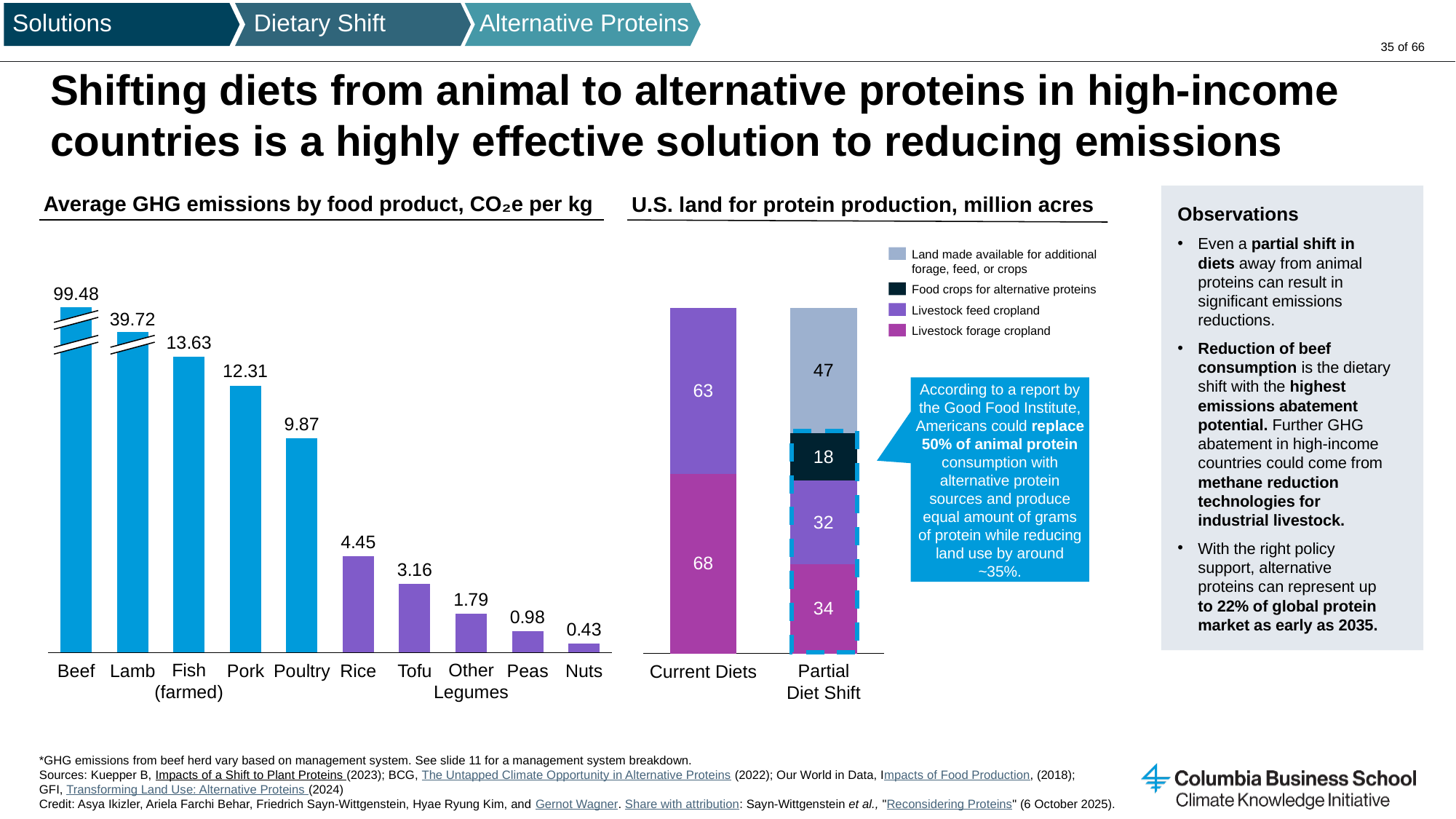
In the 'U.S. land for protein production' chart, what is the value for Food crops for alternative proteins under Partial Diet Shift? 18 In the 'Average GHG emissions by food product' chart, what is the value for Beef? 99.48 How many food products are shown in the 'Average GHG emissions by food product' chart? 10 In the 'Average GHG emissions by food product' chart, what is the difference between Lamb and Pork? 27.41 In the 'Average GHG emissions by food product' chart, what is the value for Tofu? 3.16 In the 'U.S. land for protein production' chart, what is the value for Livestock feed cropland under Current Diets? 63 In the 'Average GHG emissions by food product' chart, which is larger, Fish (farmed) or Poultry? Fish (farmed) In the 'Average GHG emissions by food product' chart, do the values rise or fall from left to right? Fall In the 'Average GHG emissions by food product' chart, which food product has the lowest emissions? Nuts In the 'U.S. land for protein production' chart, what is the total of the Current Diets bar? 131 How many series does the legend of the 'U.S. land for protein production' chart list? 4 What kind of chart is the 'U.S. land for protein production' chart? Stacked bar chart